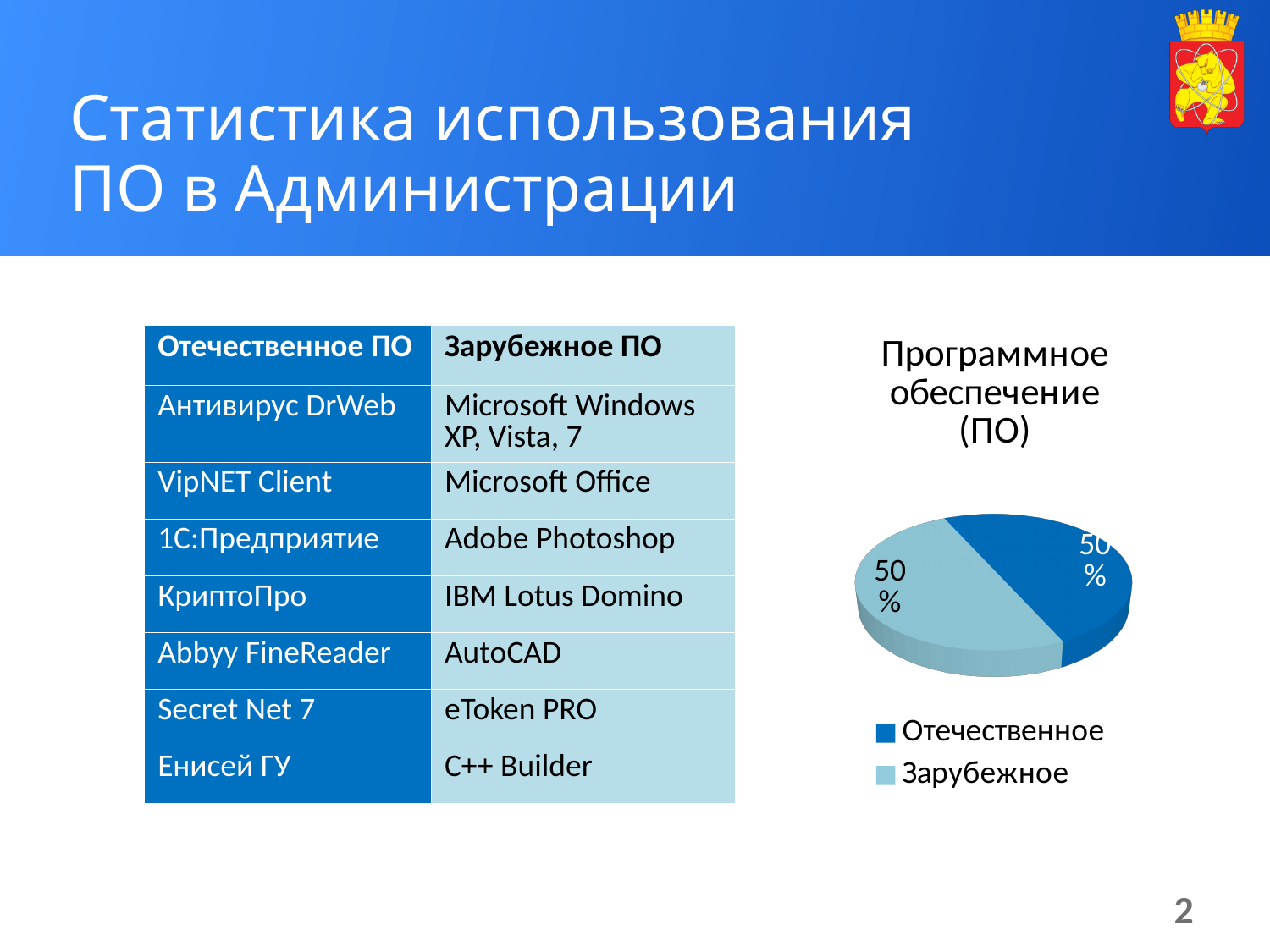
How many entries does the legend of the pie chart list? 2 What share of the pie chart is Зарубежное? 50% How many slices does the pie chart have? 2 Which legend entry of the pie chart is shown in the lighter blue colour? Зарубежное What value is labelled on the Зарубежное slice of the pie chart? 50% What value is labelled on the Отечественное slice of the pie chart? 50% What is the difference between the Отечественное and Зарубежное shares in the pie chart? 0% What is the title of the pie chart? Программное обеспечение (ПО) What kind of chart is shown on the slide? pie chart What share of the pie chart is Отечественное? 50%